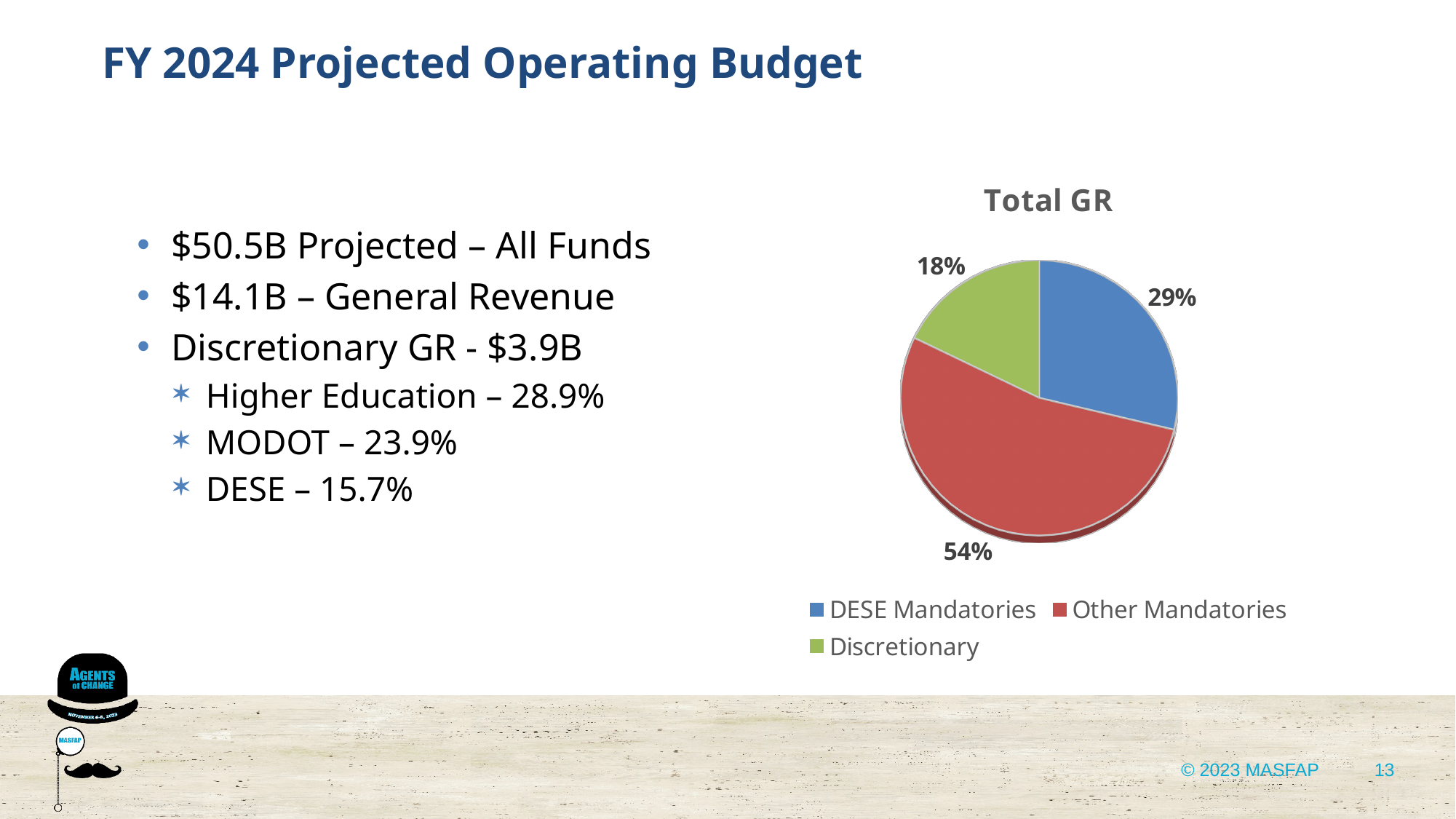
What is the title of the chart? Total GR How many entries does the legend list? 3 What colour is the Discretionary slice? Green What share of the pie is Other Mandatories? 54% Which category has the largest slice of the pie? Other Mandatories What type of chart is shown on the slide? Pie chart Which is larger, the DESE Mandatories slice or the Discretionary slice? DESE Mandatories What share of the pie is Discretionary? 18% How many slices does the pie chart have? 3 What share of the pie is DESE Mandatories? 29% What is the difference in percentage points between Other Mandatories and DESE Mandatories? 25 Which category has the smallest slice of the pie? Discretionary